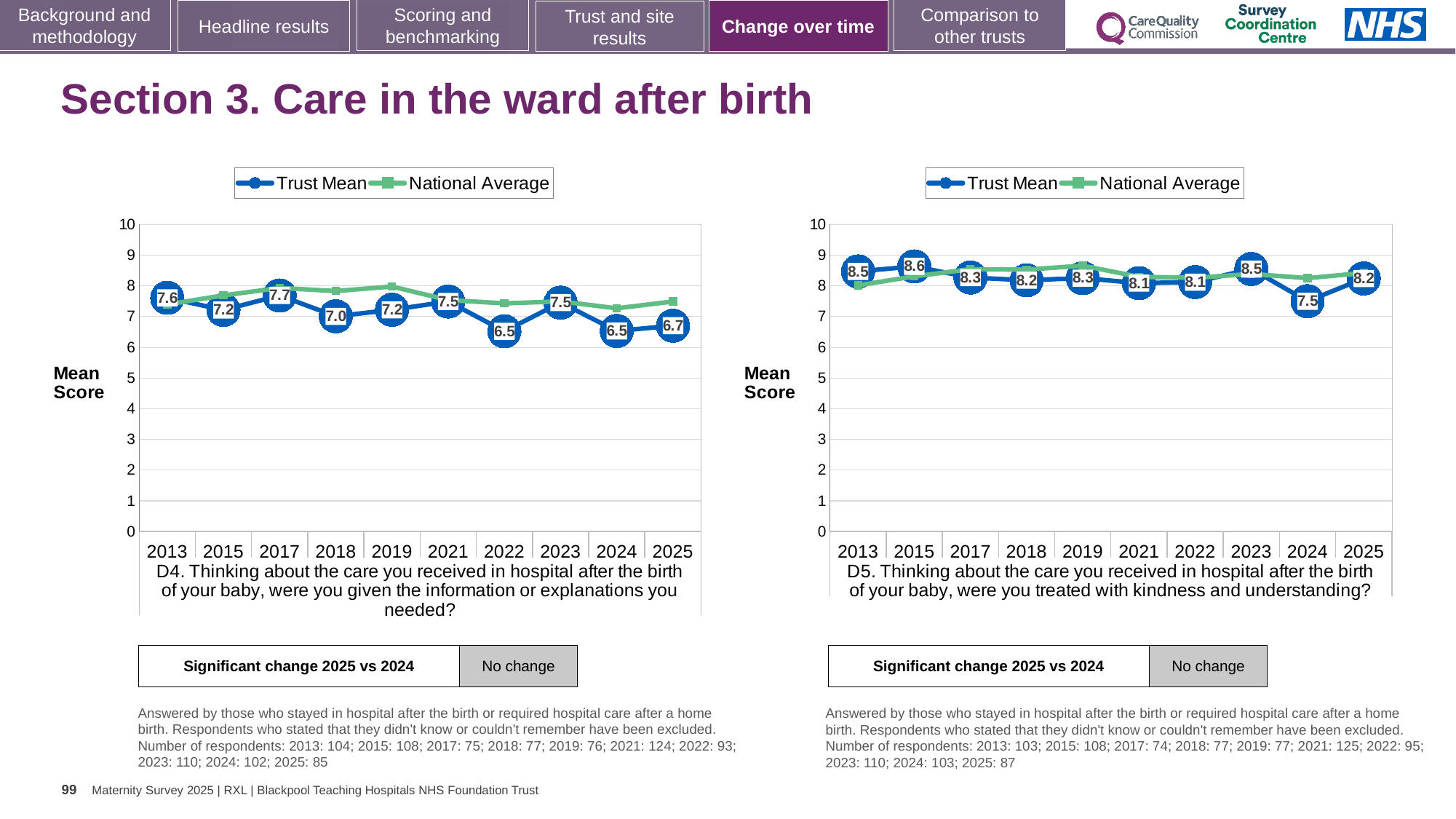
In the D4 chart on the left, what is the difference between the Trust Mean scores for 2017 and 2018? 0.7 In the D4 chart on the left, is the National Average for 2025 greater or less than 7? greater How many years are plotted on the x axis of the D5 chart on the right? 10 In the D4 chart on the left, is the Trust Mean score higher in 2013 or in 2015? 2013 What type of chart is the D5 chart on the right? Line chart How many series does the legend of the D4 chart on the left list? 2 In the D5 chart on the right, which year has the highest Trust Mean score? 2015 In the D5 chart on the right, what is the difference between the Trust Mean scores for 2025 and 2024? 0.7 In the D4 chart on the left, which year has the highest Trust Mean score? 2017 In the D5 chart on the right, which year has the lowest Trust Mean score? 2024 In the D4 chart on the left, what is the Trust Mean score for 2025? 6.7 In the D5 chart on the right, what is the Trust Mean score for 2024? 7.5